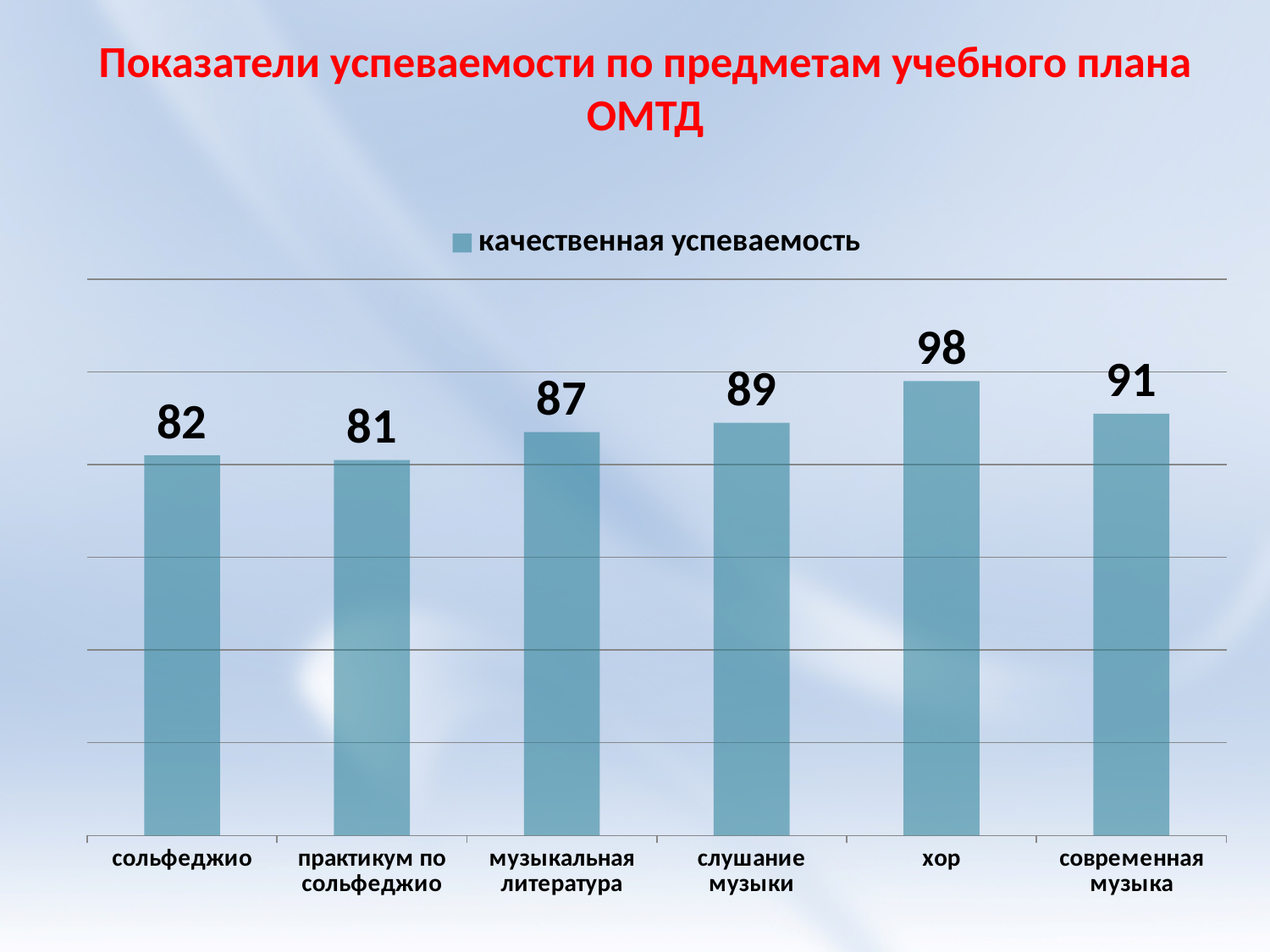
What is the value for сольфеджио? 82 What is the value for современная музыка? 91 How many categories are shown on the x axis? 6 Which category has the highest value? хор What is the value for хор? 98 Which category has the lowest value? практикум по сольфеджио What is the difference between the values for хор and сольфеджио? 16 What kind of chart is shown on the slide? bar chart Which is larger, the value for музыкальная литература or the value for слушание музыки? слушание музыки What is the difference between the values for современная музыка and практикум по сольфеджио? 10 How many series does the legend list? 1 What is the name of the series in the legend? качественная успеваемость